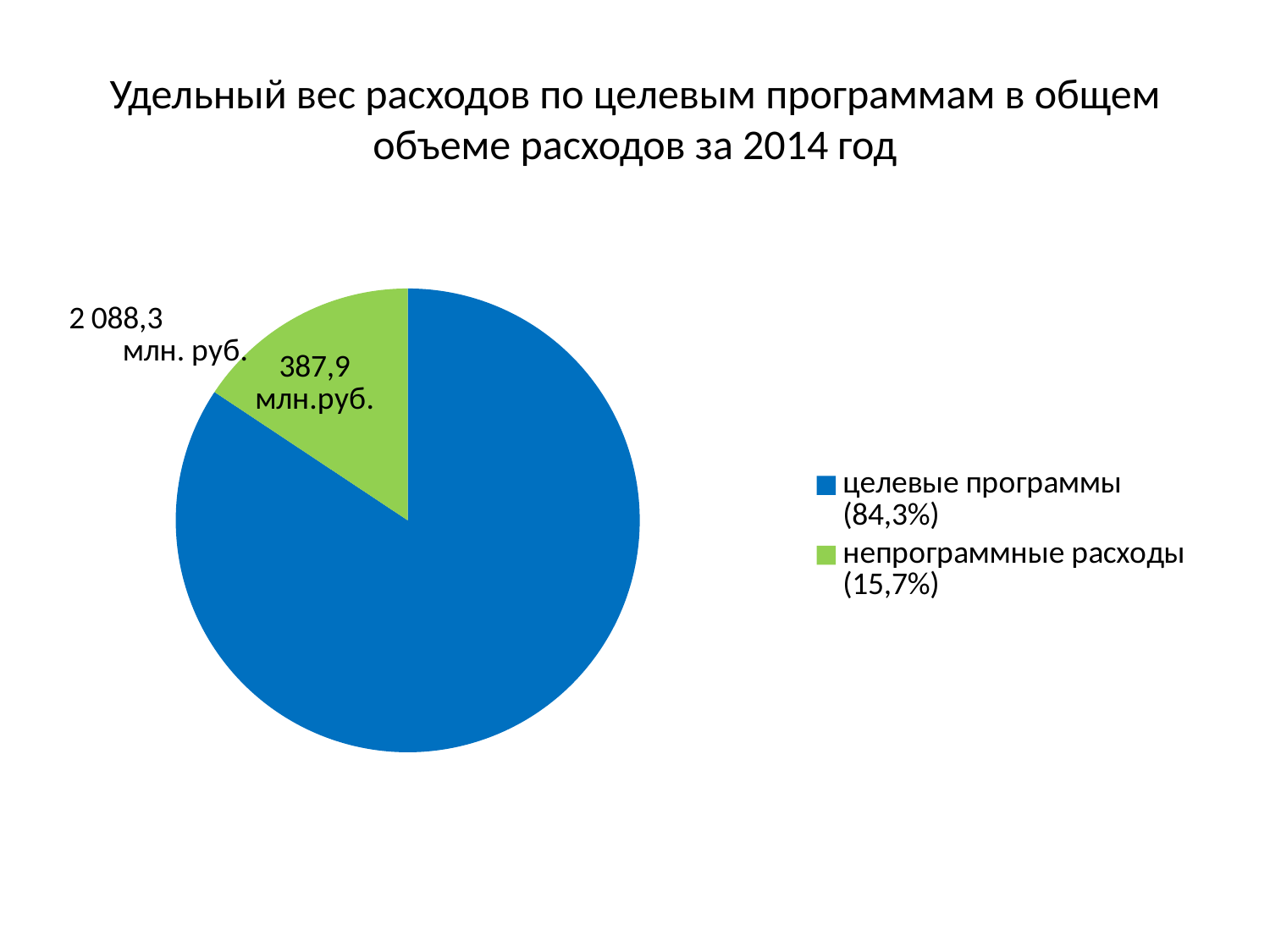
Which slice of the pie is the smallest? непрограммные расходы Which slice of the pie is the largest? целевые программы What is the value shown for целевые программы? 2 088,3 млн. руб. What kind of chart is shown on the slide? pie chart What colour is the slice for непрограммные расходы? green Which is larger, целевые программы or непрограммные расходы? целевые программы What is the value shown for непрограммные расходы? 387,9 млн.руб. How many entries does the legend list? 2 What is the difference between the values for целевые программы and непрограммные расходы? 1 700,4 млн. руб. How many slices does the pie chart have? 2 What share of the pie does целевые программы take? 84,3% What share of the pie does непрограммные расходы take? 15,7%